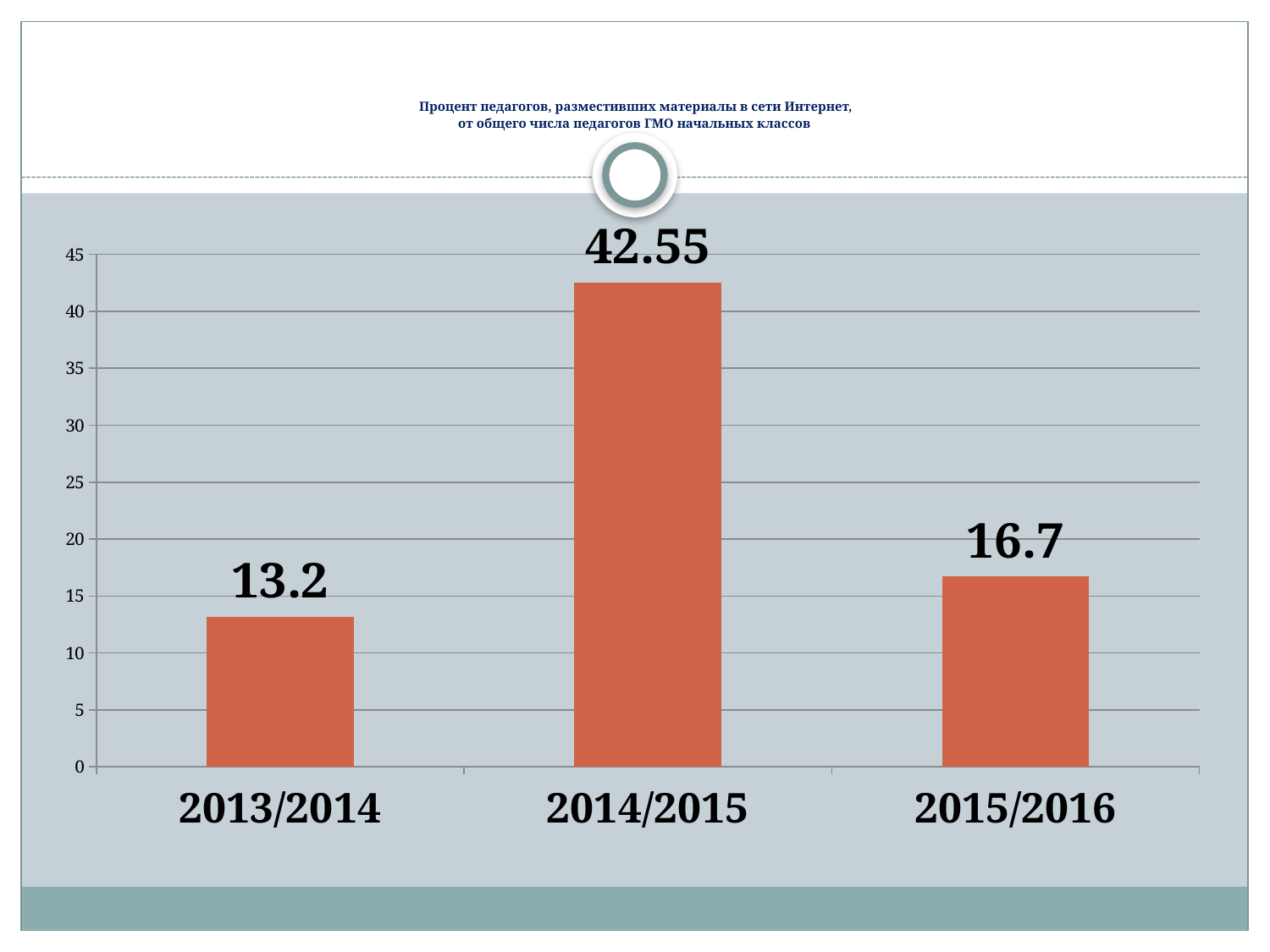
What is the value for 2014/2015? 42.55 Which year has the lowest value? 2013/2014 What colour are the bars in the chart? orange-red What is the difference between the values for 2014/2015 and 2013/2014? 29.35 What is the value for 2013/2014? 13.2 Is the value for 2014/2015 greater or less than 40? greater What kind of chart is shown on the slide? bar chart What is the value for 2015/2016? 16.7 Which year has the highest value? 2014/2015 How many categories are shown on the x axis? 3 What is the difference between the values for 2015/2016 and 2013/2014? 3.5 Which is larger, the value for 2015/2016 or the value for 2013/2014? 2015/2016